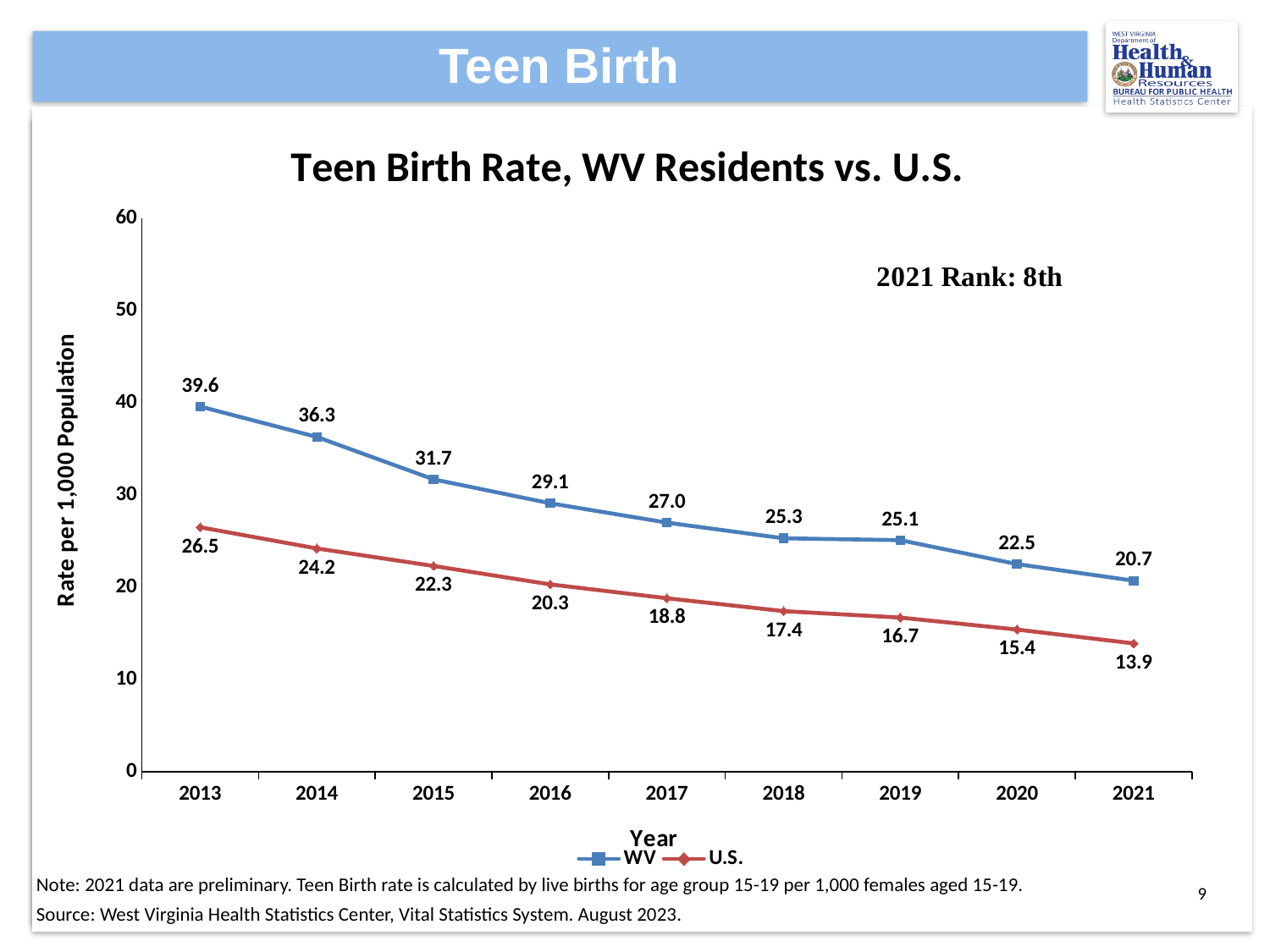
What is the difference between the WV and U.S. teen birth rates in 2021? 6.8 What was the U.S. teen birth rate in 2021? 13.9 How many years are shown on the x axis? 9 What was the WV teen birth rate in 2017? 27.0 In which year was the U.S. teen birth rate lowest? 2021 What was the WV teen birth rate in 2013? 39.6 How many series does the legend list? 2 In which year was the WV teen birth rate highest? 2013 Is the WV teen birth rate in 2019 greater or less than 30? less Does the WV teen birth rate rise or fall from 2013 to 2021? fall What kind of chart is shown? line chart Which had the higher teen birth rate in 2016, WV or U.S.? WV